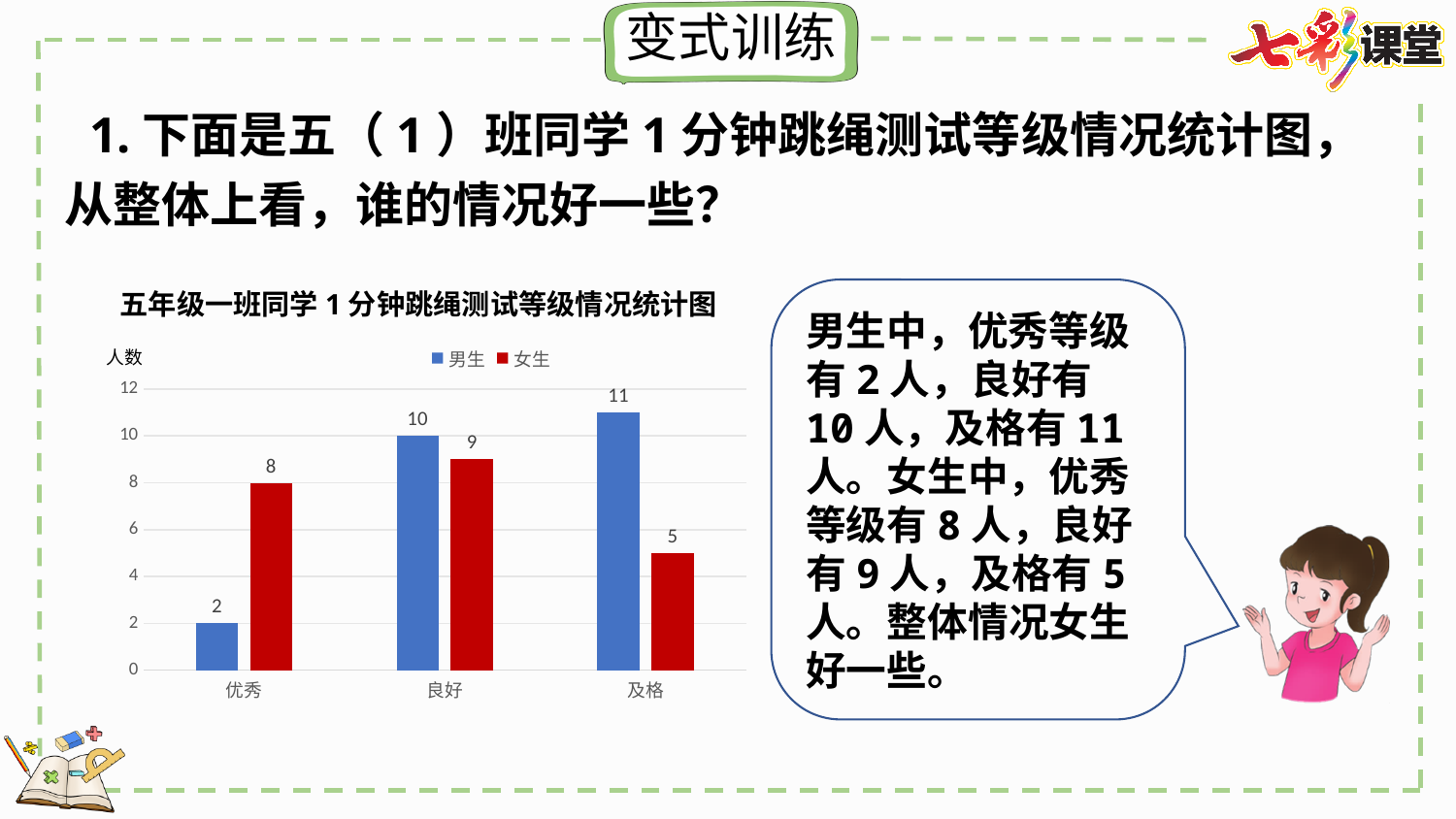
What is the value for 女生 in the 良好 category? 9 What is the value for 男生 in the 及格 category? 11 What is the value for 男生 in the 优秀 category? 2 In the 优秀 category, which series has the larger value, 男生 or 女生? 女生 What is the difference between 男生 and 女生 in the 及格 category? 6 How many categories are shown on the x axis? 3 What kind of chart is shown on the slide? bar chart Which category has the highest value for 女生? 良好 Which category has the lowest value for 男生? 优秀 Is the value for 女生 in the 及格 category greater or less than 6? less What is the title of the chart? 五年级一班同学1分钟跳绳测试等级情况统计图 How many series does the legend list? 2